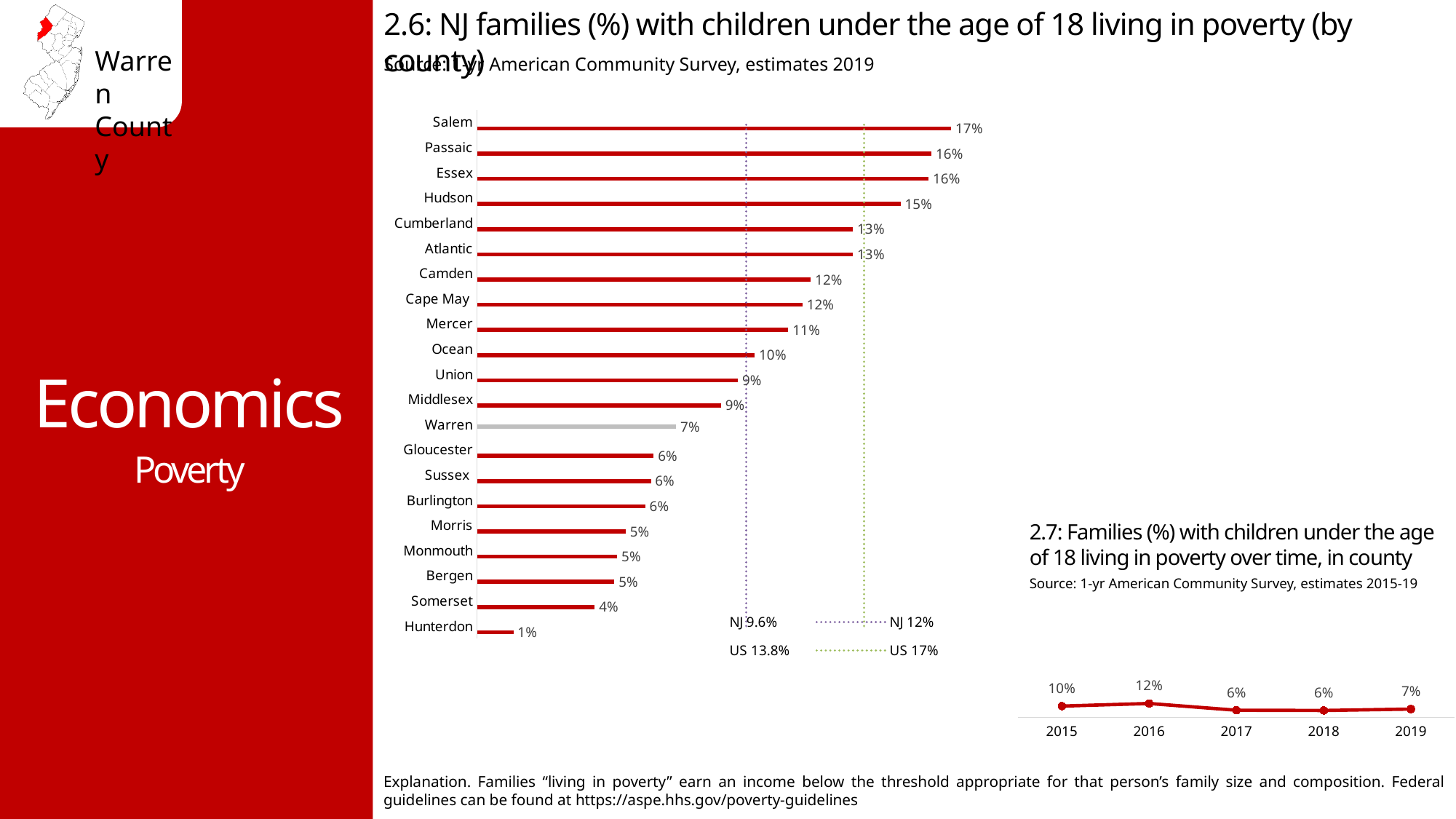
What kind of chart is chart 2.6 (by county)? Bar chart In chart 2.6 (by county), what is the value for Hudson? 15% In chart 2.6 (by county), how many counties are shown? 21 In chart 2.7 (over time), what is the difference between the values for 2015 and 2019? 3% In chart 2.7 (families in poverty over time, in county), what is the value for 2016? 12% In chart 2.6 (by county), what is the difference between the values for Salem and Warren? 10% In chart 2.6 (by county), which has a larger value, Mercer or Somerset? Mercer In chart 2.7 (over time), which year has the highest value? 2016 In chart 2.6 (by county), which county has the highest value? Salem In chart 2.6 (NJ families with children under 18 living in poverty by county), what is the value for Warren? 7% In chart 2.7 (over time), how many years are plotted? 5 In chart 2.6 (by county), which county has the lowest value? Hunterdon